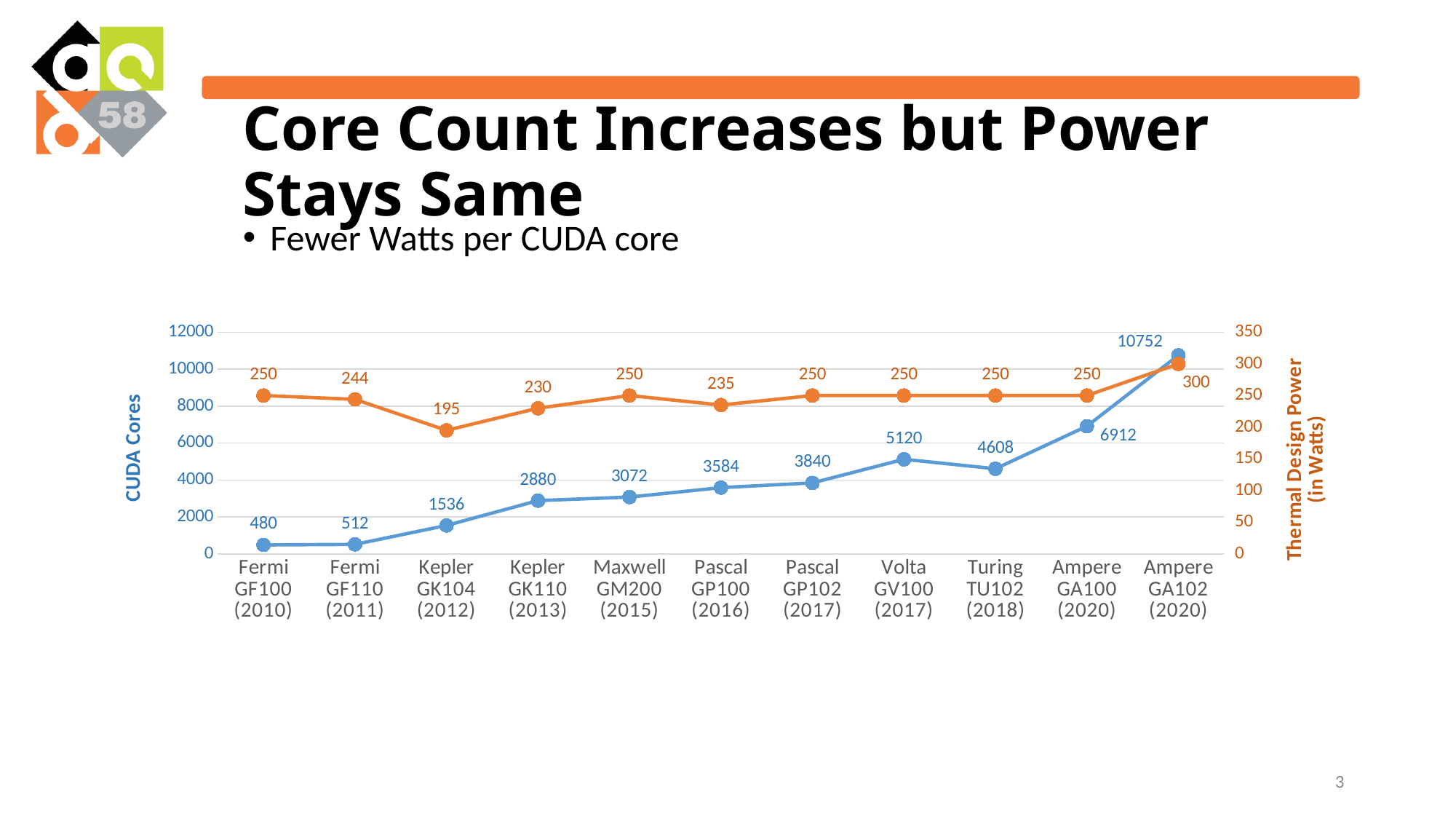
What is the title of the right-hand vertical axis? Thermal Design Power (in Watts) Which GPU has the lowest Thermal Design Power? Kepler GK104 (2012) What kind of chart is shown on the slide? line chart What is the difference in Thermal Design Power between Ampere GA102 (2020) and Pascal GP100 (2016)? 65 What is the Thermal Design Power for Kepler GK104 (2012)? 195 Does the CUDA Cores series generally rise or fall from Fermi GF100 (2010) to Ampere GA102 (2020)? rise What is the CUDA core count for Kepler GK110 (2013)? 2880 What is the difference in CUDA cores between Ampere GA102 (2020) and Ampere GA100 (2020)? 3840 Which GPU has the highest CUDA core count? Ampere GA102 (2020) How many GPU categories are plotted along the x axis? 11 What is the CUDA core count for Ampere GA102 (2020)? 10752 Which has more CUDA cores, Volta GV100 (2017) or Turing TU102 (2018)? Volta GV100 (2017)